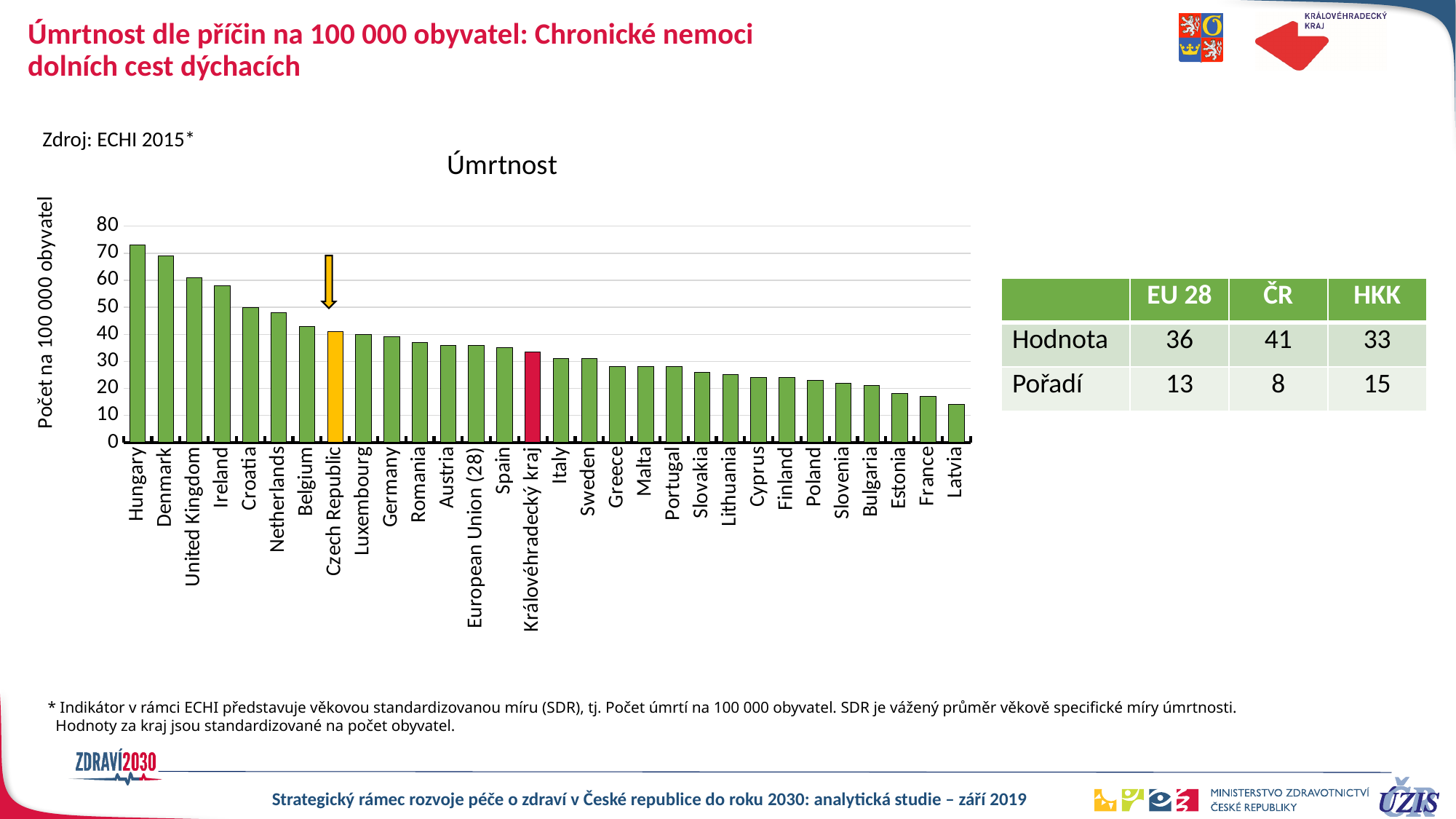
Do the values rise or fall from left to right along the x axis? fall Is the value for Netherlands greater or less than 50? less Which is larger, the value for Denmark or the value for Ireland? Denmark How many categories (bars) are plotted in the chart? 30 Which is larger, the value for Czech Republic or the value for Královéhradecký kraj? Czech Republic Is the value for Latvia greater or less than 20? less Which country has the highest mortality value in the chart? Hungary Is the value for Greece greater or less than 30? less Which country has the lowest mortality value in the chart? Latvia What kind of chart is shown on the slide? bar chart What is the title of the chart? Úmrtnost